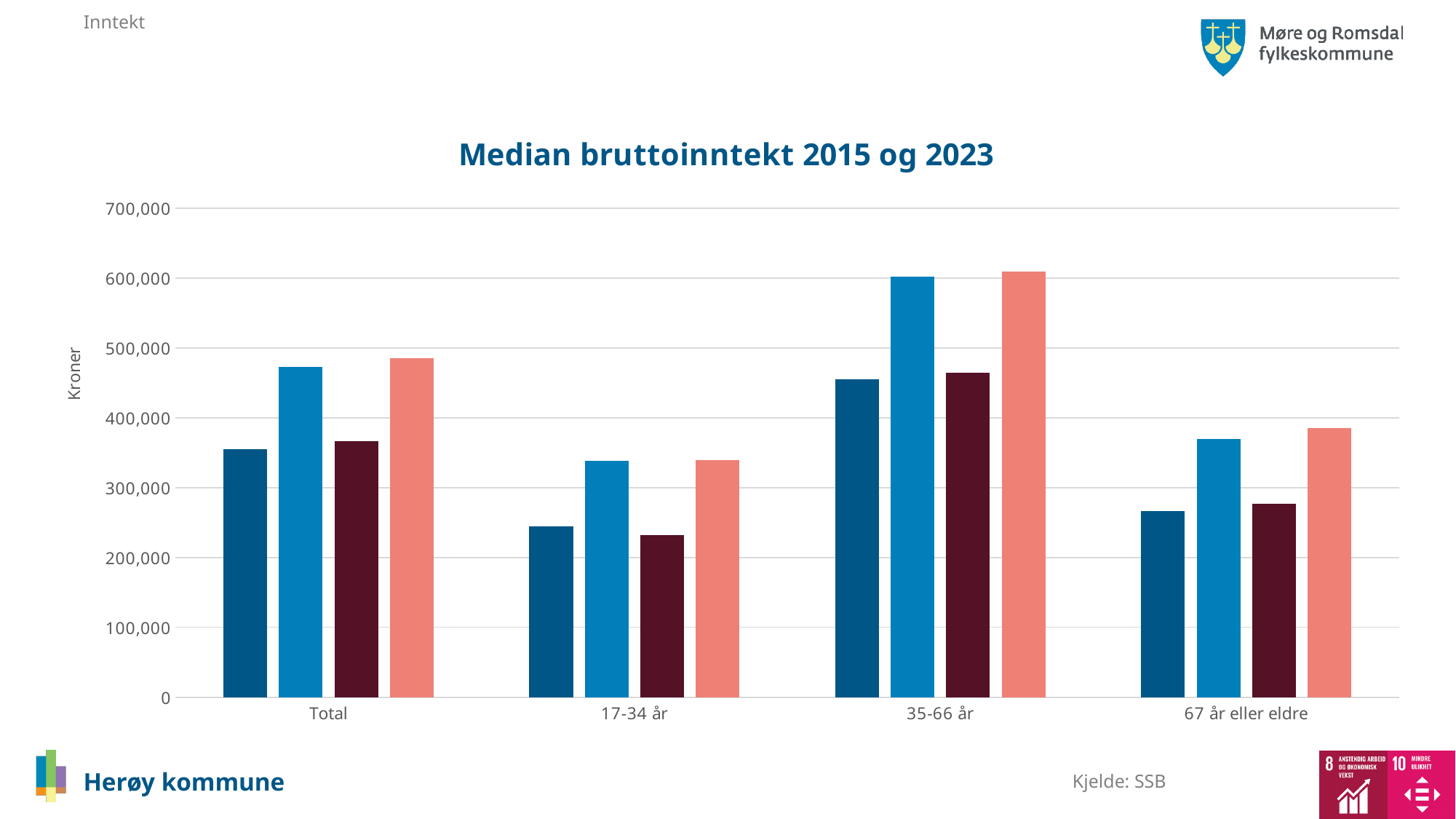
What is the label on the y axis of the chart? Kroner For 67 år eller eldre, which is taller: the light blue bar or the dark maroon bar? the light blue bar How many bars are plotted for each category in the chart? 4 Which category has the shortest bars in the chart? 17-34 år How many categories are shown on the x axis of the chart? 4 What is the title of the chart? Median bruttoinntekt 2015 og 2023 Which category has the tallest bars in the chart? 35-66 år Is the value of the dark blue (first) bar for 17-34 år greater or less than 300,000? less What kind of chart is shown on the slide? bar chart Is the value of the light blue bar for 35-66 år greater or less than 500,000? greater Is the value of the salmon (last) bar for Total greater or less than 400,000? greater Is the salmon (last) bar larger for Total or for 67 år eller eldre? Total